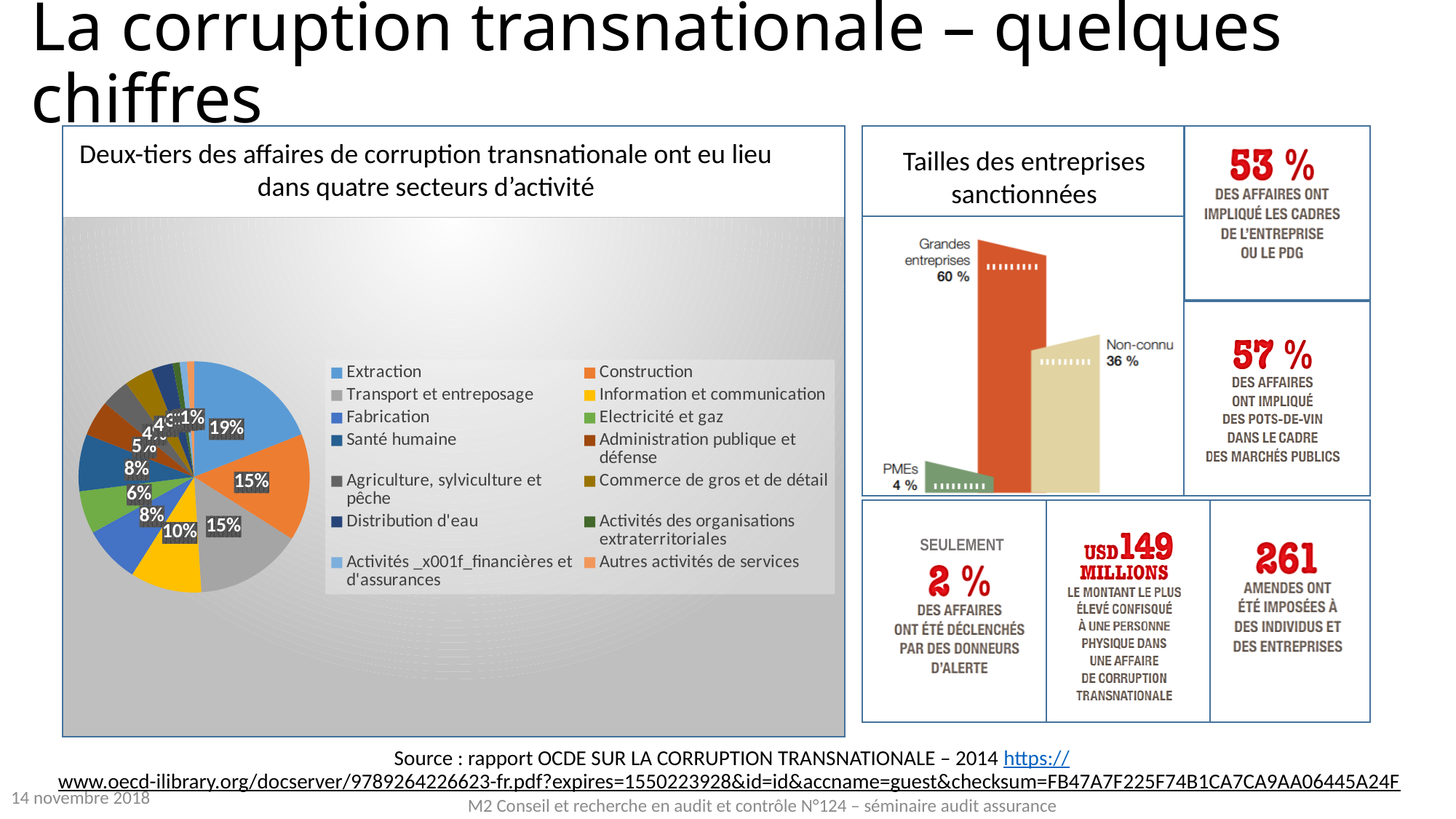
In the pie chart on the left, what share does Information et communication have? 10% In the pie chart on the left, what share does Electricité et gaz have? 6% What type of chart is the chart on the left of the slide? Pie chart In the pie chart 'Deux-tiers des affaires de corruption transnationale ont eu lieu dans quatre secteurs d'activité', what share does Extraction have? 19% In the pie chart on the left, what share does Construction have? 15% In the chart 'Tailles des entreprises sanctionnées', what is the value for Grandes entreprises? 60 % In the pie chart on the left, which is larger: the share of Fabrication or the share of Electricité et gaz? Fabrication In the chart 'Tailles des entreprises sanctionnées', which category has the lowest value? PMEs In the pie chart on the left, which sector has the largest share? Extraction In the chart 'Tailles des entreprises sanctionnées', what is the difference between Grandes entreprises and Non-connu? 24 % In the pie chart on the left, what is the difference between the shares of Extraction and Information et communication? 9% How many sectors does the legend of the pie chart on the left list? 14